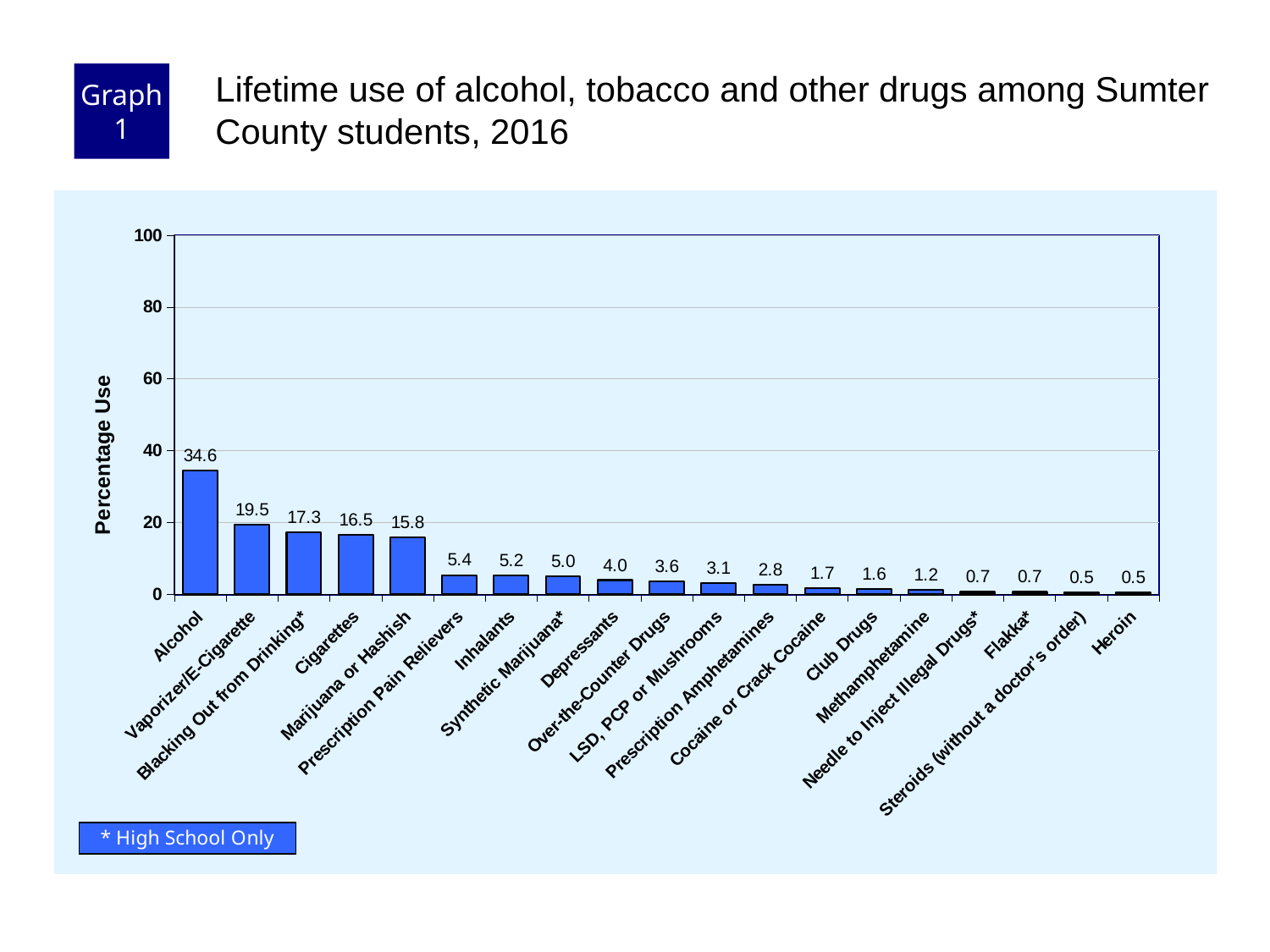
What is the label on the vertical axis of the chart? Percentage Use What is the percentage use for Alcohol? 34.6 Is the value for Alcohol greater or less than 40? less What is the percentage use for Methamphetamine? 1.2 What is the lowest percentage use value shown on the chart? 0.5 What is the percentage use for Cigarettes? 16.5 What kind of chart is shown on the slide? Bar chart Which category has the highest percentage use? Alcohol Which has a higher percentage use, Marijuana or Hashish or Prescription Pain Relievers? Marijuana or Hashish What is the difference in percentage use between Alcohol and Vaporizer/E-Cigarette? 15.1 What is the percentage use for Inhalants? 5.2 How many categories are shown on the chart? 19